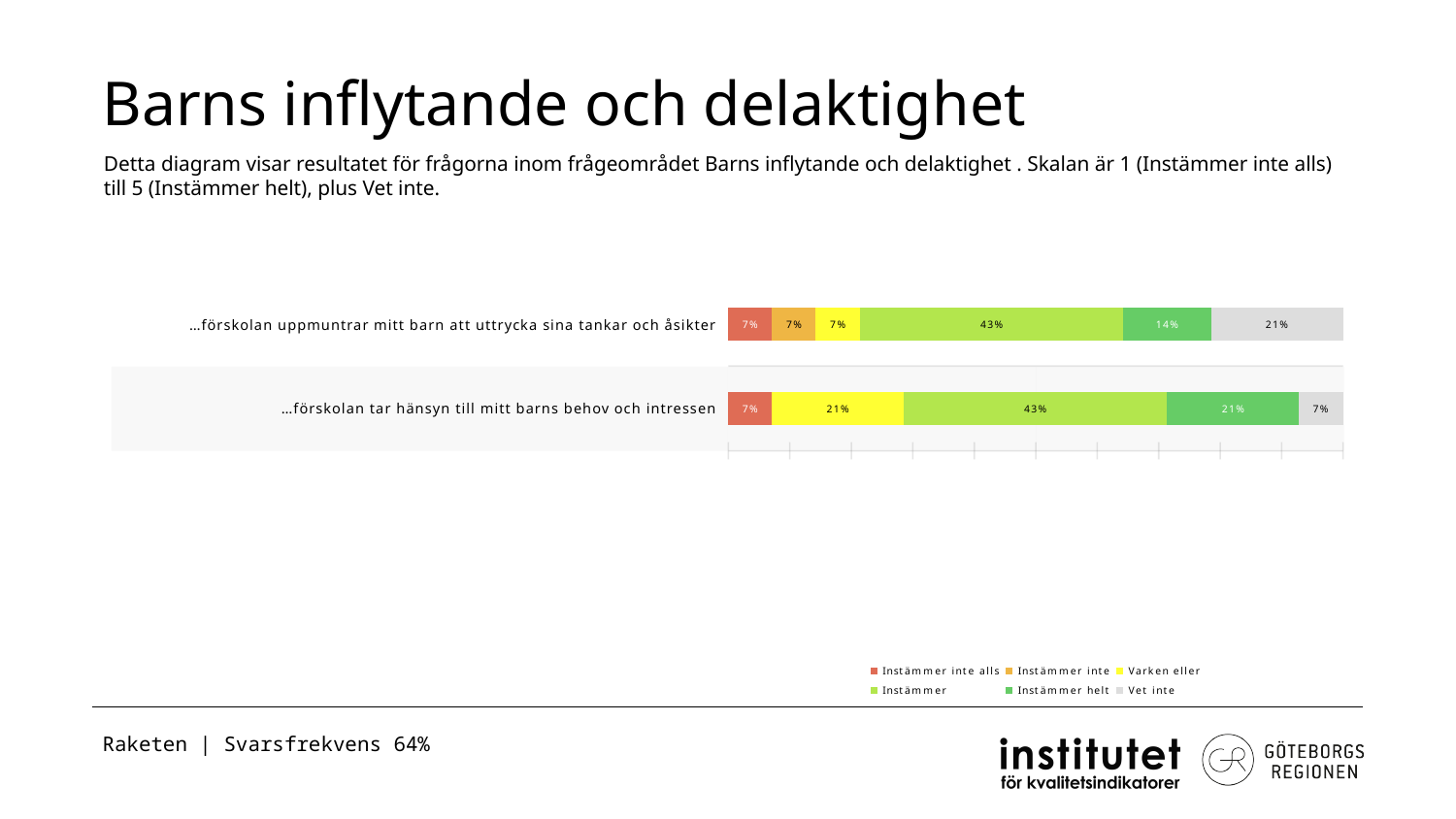
What is the value of the Instämmer helt segment for "…förskolan uppmuntrar mitt barn att uttrycka sina tankar och åsikter"? 14% How many categories (questions) are plotted in the chart? 2 Which segment is the largest in the bar for "…förskolan tar hänsyn till mitt barns behov och intressen"? Instämmer What is the value of the Vet inte segment for "…förskolan uppmuntrar mitt barn att uttrycka sina tankar och åsikter"? 21% What is the value of the Instämmer segment for "…förskolan uppmuntrar mitt barn att uttrycka sina tankar och åsikter"? 43% How many series does the legend list? 6 What is the value of the Varken eller segment for "…förskolan tar hänsyn till mitt barns behov och intressen"? 21% What is the difference between the Instämmer helt values for the two questions? 7% Which question has the larger Vet inte share: "…förskolan uppmuntrar mitt barn att uttrycka sina tankar och åsikter" or "…förskolan tar hänsyn till mitt barns behov och intressen"? …förskolan uppmuntrar mitt barn att uttrycka sina tankar och åsikter What is the value of the Instämmer helt segment for "…förskolan tar hänsyn till mitt barns behov och intressen"? 21% What kind of chart is shown on the slide? stacked bar chart Which legend entry is shown in red? Instämmer inte alls